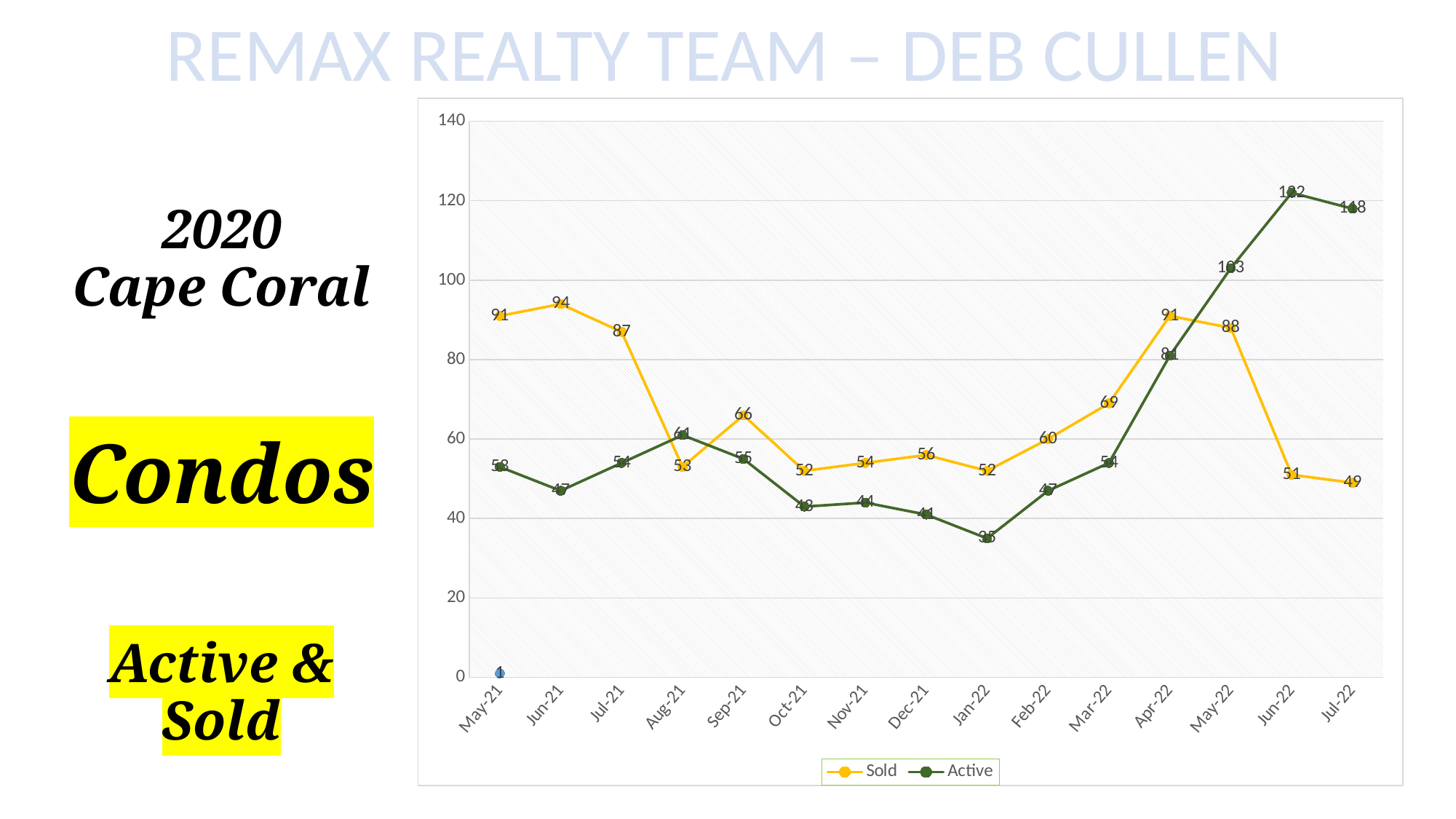
How many series does the legend list? 2 What is the Sold value for Apr-22? 91 What is the Active value for Jan-22? 35 What kind of chart is shown on the slide? line chart What is the difference between the Sold values for Mar-22 and Feb-22? 9 In which month is the Active series at its lowest? Jan-22 In which month is the Sold series at its highest? Jun-21 How many months are shown on the x axis? 15 What is the Active value for May-22? 103 Is the Active value for Jul-22 greater or less than 100? greater In Apr-22, which series has the larger value, Sold or Active? Sold What is the Sold value for Jun-21? 94